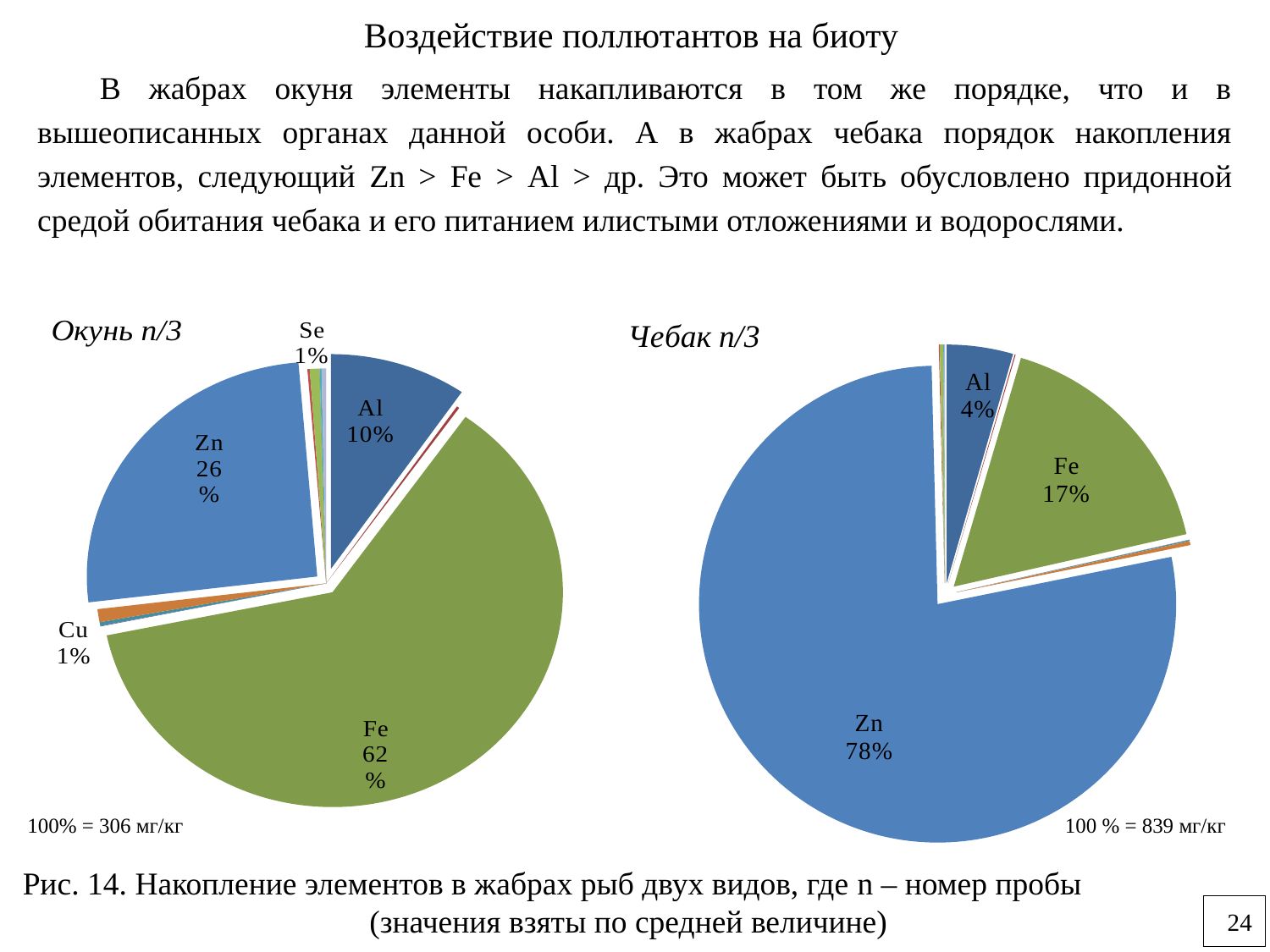
In the right pie chart (Чебак n/3), what share does Al have? 4% In the right pie chart (Чебак n/3), what share does Zn have? 78% In the right pie chart (Чебак n/3), which element has the largest share? Zn What type of chart is used on this slide? Pie chart In the left pie chart (Окунь n/3), what share does Zn have? 26% In the right pie chart (Чебак n/3), which is larger, the share of Fe or the share of Al? Fe In the left pie chart (Окунь n/3), what is the difference in percentage points between the Fe share and the Zn share? 36 In the left pie chart (Окунь n/3), which element has the largest share? Fe